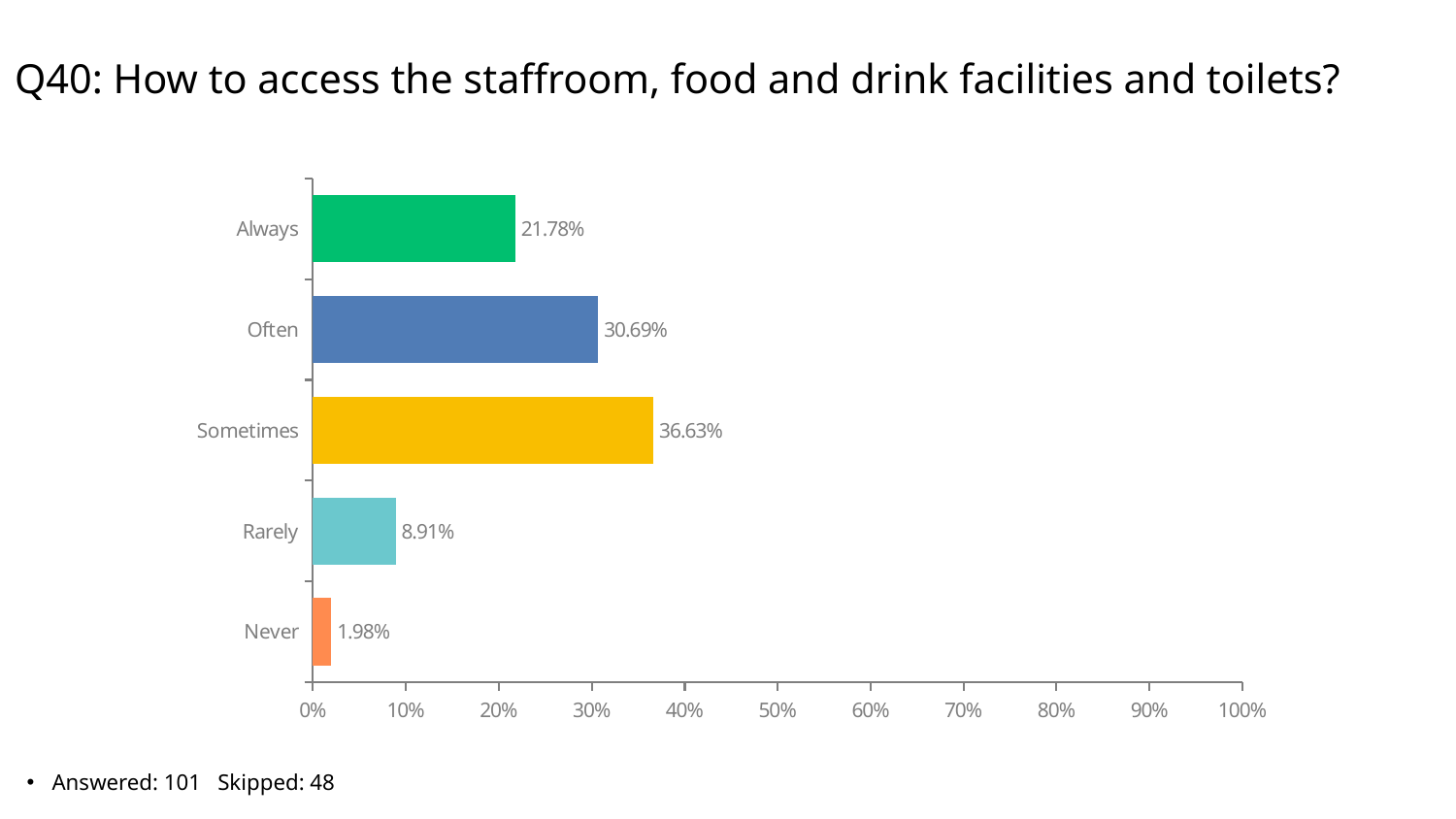
What is the difference between the values for "Rarely" and "Never"? 6.93% What is the difference between the values for "Sometimes" and "Always"? 14.85% How many categories are shown in the chart? 5 Which category has the lowest value? Never What percentage is shown for "Often"? 30.69% What kind of chart is shown on the slide? Bar chart What is the value shown for "Never"? 1.98% What is the maximum value shown on the x axis? 100% What percentage of respondents answered "Sometimes"? 36.63% Is the value for "Rarely" greater or less than 10%? less Which is larger, the value for "Often" or the value for "Always"? Often Which category has the highest value? Sometimes